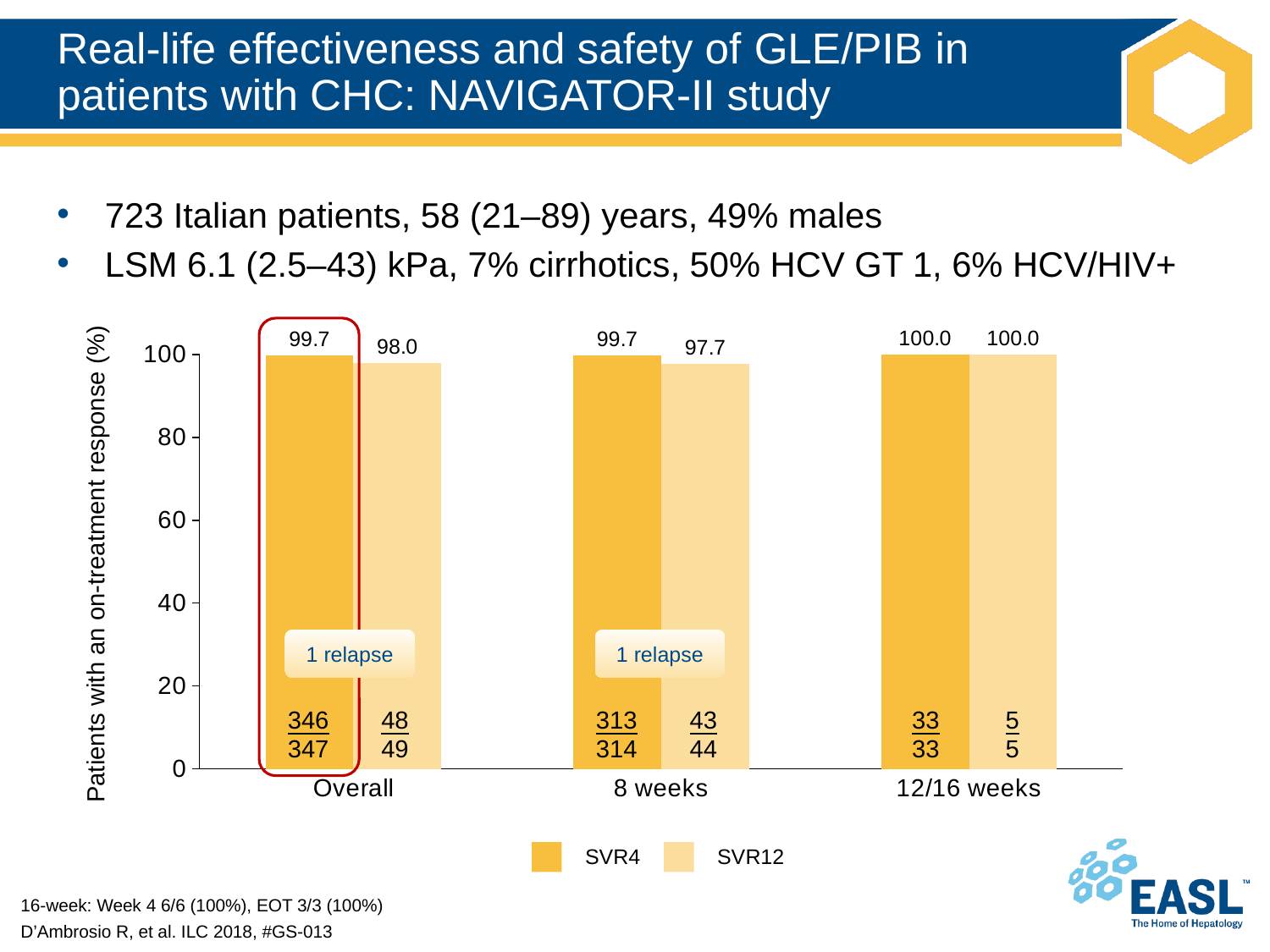
Which category has the lowest SVR12 value? 8 weeks What fraction is printed on the SVR4 bar for the 8 weeks group? 313/314 How many categories are shown on the x axis? 3 What kind of chart is shown on the slide? Bar chart What is the y-axis label of the chart? Patients with an on-treatment response (%) What is the SVR12 value for the 8 weeks group? 97.7 What is the SVR12 value for the Overall group? 98.0 What is the SVR4 value for the Overall group? 99.7 Which is larger for the Overall group, SVR4 or SVR12? SVR4 How many series does the legend list? 2 What is the SVR12 value for the 12/16 weeks group? 100.0 What is the difference between the SVR4 and SVR12 values for the 8 weeks group? 2.0